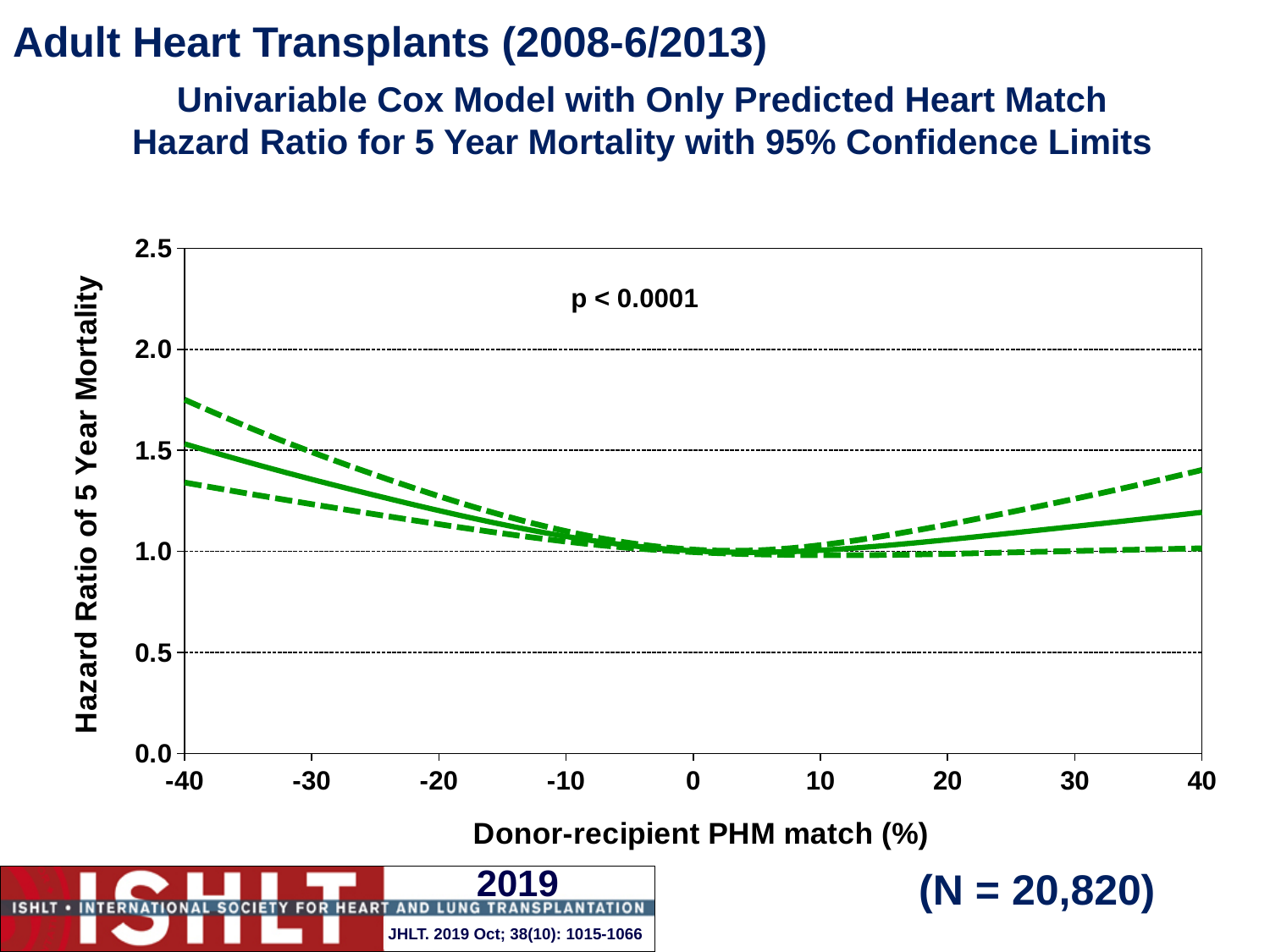
Does the solid hazard ratio line rise or fall as the donor-recipient PHM match goes from 10% to 40%? rise Is the value of the solid hazard ratio line at a donor-recipient PHM match of 40% greater or less than 1.0? greater Does the solid hazard ratio line rise or fall as the donor-recipient PHM match goes from -40% to 0%? fall Is the solid hazard ratio line at a donor-recipient PHM match of -40% greater or less than 2.0? less What p-value is printed on the chart? p < 0.0001 Is the upper dashed confidence limit at a donor-recipient PHM match of 40% greater or less than 1.5? less What is the label of the x axis? Donor-recipient PHM match (%) What kind of chart is shown on the slide? line chart Is the hazard ratio at a donor-recipient PHM match of -40% larger or smaller than at 40%? larger